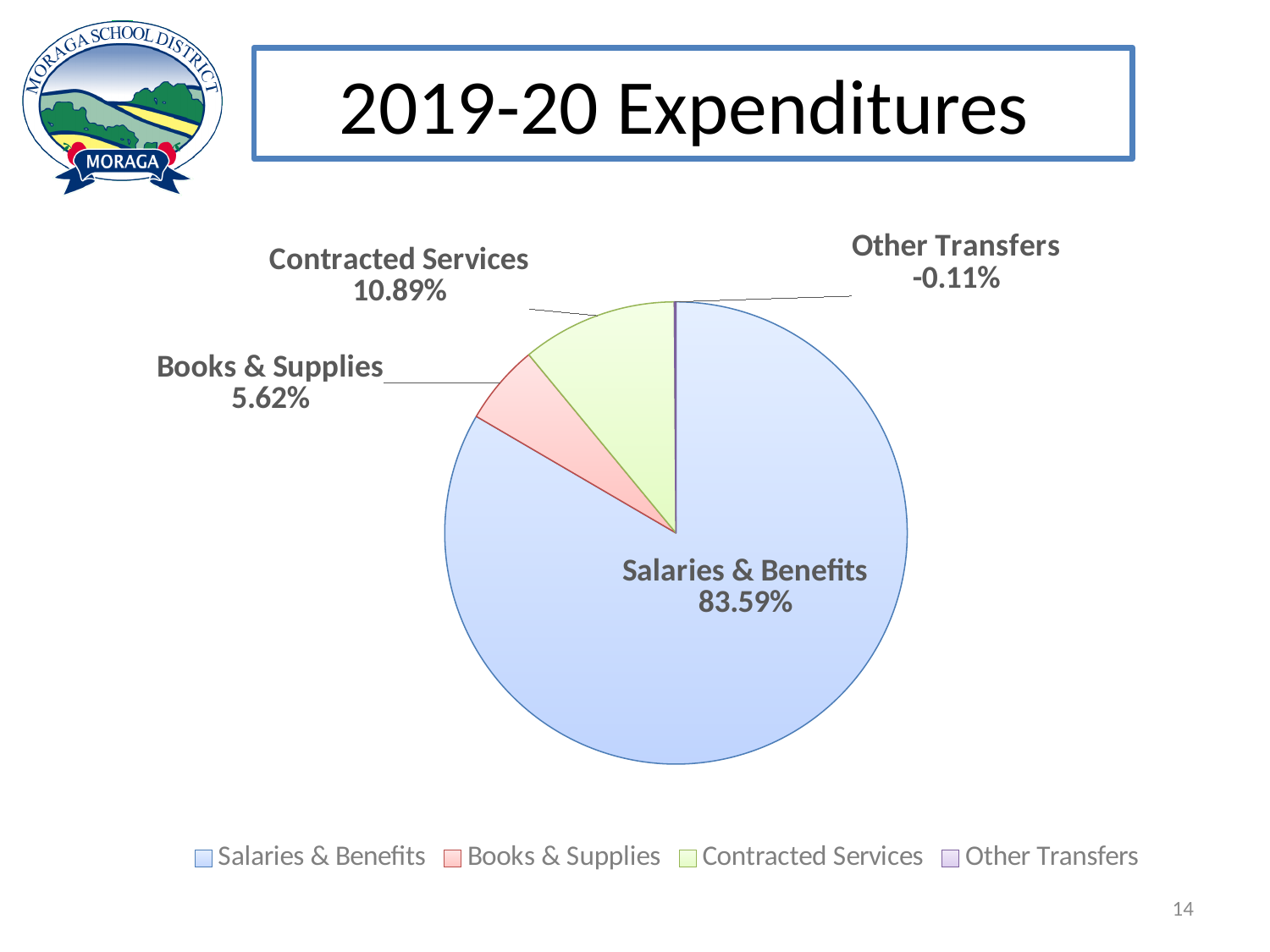
What share of 2019-20 expenditures is Salaries & Benefits? 83.59% Which category has the largest share of expenditures? Salaries & Benefits What share of 2019-20 expenditures is Contracted Services? 10.89% What value is shown for Other Transfers? -0.11% Which is larger, Contracted Services or Books & Supplies? Contracted Services How many categories does the legend list? 4 What colour is the Salaries & Benefits slice? Blue What kind of chart is shown on the slide? Pie chart What share of 2019-20 expenditures is Books & Supplies? 5.62% What is the difference between the Contracted Services share and the Books & Supplies share? 5.27% Which category has the smallest value in the chart? Other Transfers What is the title of the slide? 2019-20 Expenditures